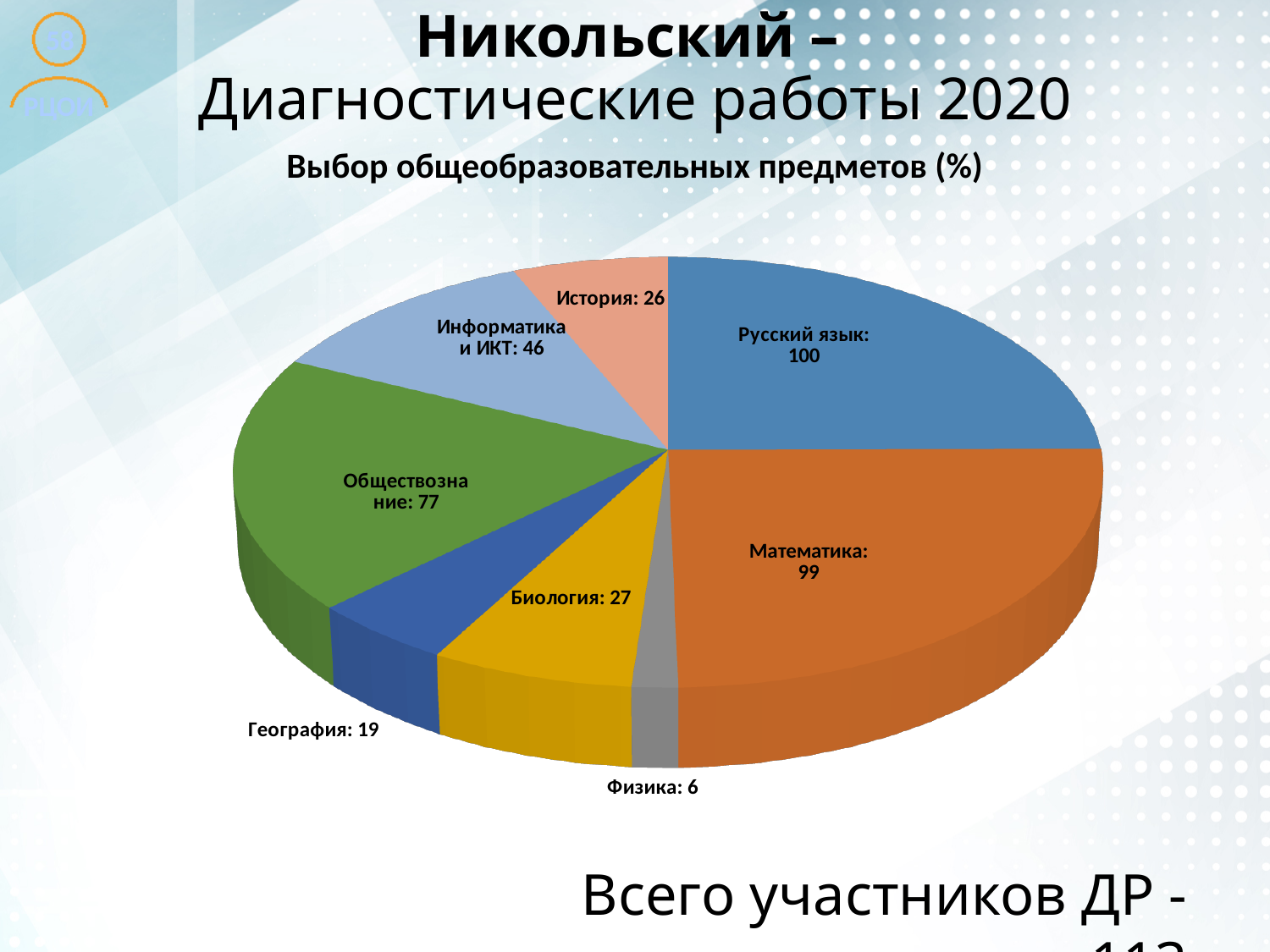
What is the value for Физика? 6 Which subject has the lowest value? Физика What is the value for Обществознание? 77 How many subjects (slices) are shown in the pie chart? 8 What is the value for Русский язык? 100 What is the value for Информатика и ИКТ? 46 What is the difference between the values for Обществознание and Информатика и ИКТ? 31 What is the title of the chart? Выбор общеобразовательных предметов (%) What kind of chart is shown on the slide? pie chart What is the value for Математика? 99 Which subject has the highest value? Русский язык Which is larger, the value for Биология or the value for География? Биология